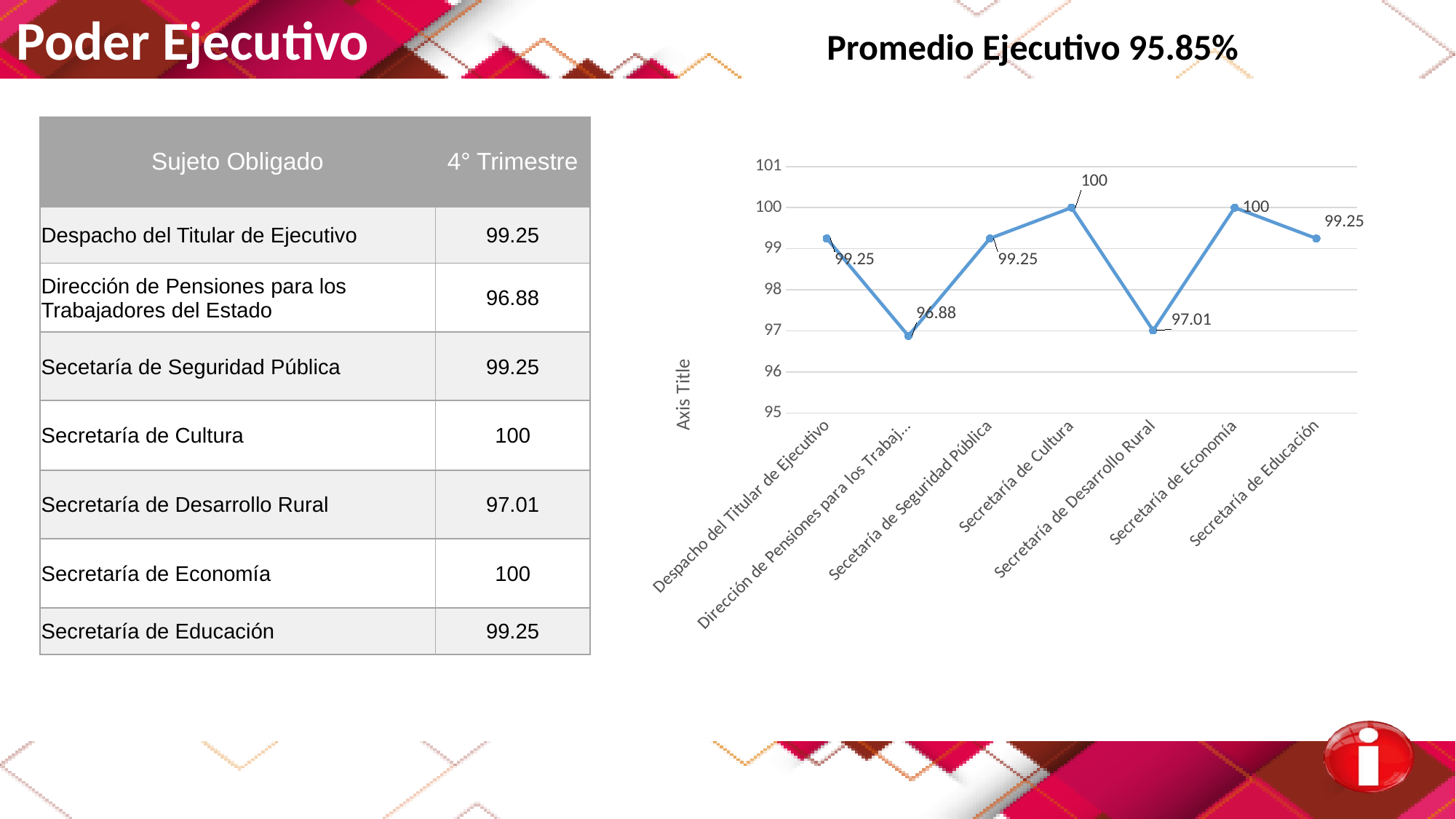
Does the line rise or fall between Secretaría de Cultura and Secretaría de Desarrollo Rural? fall What is the value for Secretaría de Desarrollo Rural in the chart? 97.01 How many categories are plotted in the chart? 7 What is the difference between the values for Secretaría de Educación and Dirección de Pensiones para los Trabajadores del Estado? 2.37 What is the label on the vertical axis of the chart? Axis Title What type of chart is shown on the slide? line chart Is the value for Dirección de Pensiones para los Trabajadores del Estado greater or less than 97? less What is the value for Secretaría de Cultura in the chart? 100 Which is larger, the value for Secetaría de Seguridad Pública or the value for Secretaría de Desarrollo Rural? Secetaría de Seguridad Pública Which category has the lowest value in the chart? Dirección de Pensiones para los Trabajadores del Estado What is the difference between the values for Secretaría de Economía and Secretaría de Desarrollo Rural? 2.99 What is the value for Despacho del Titular de Ejecutivo in the chart? 99.25